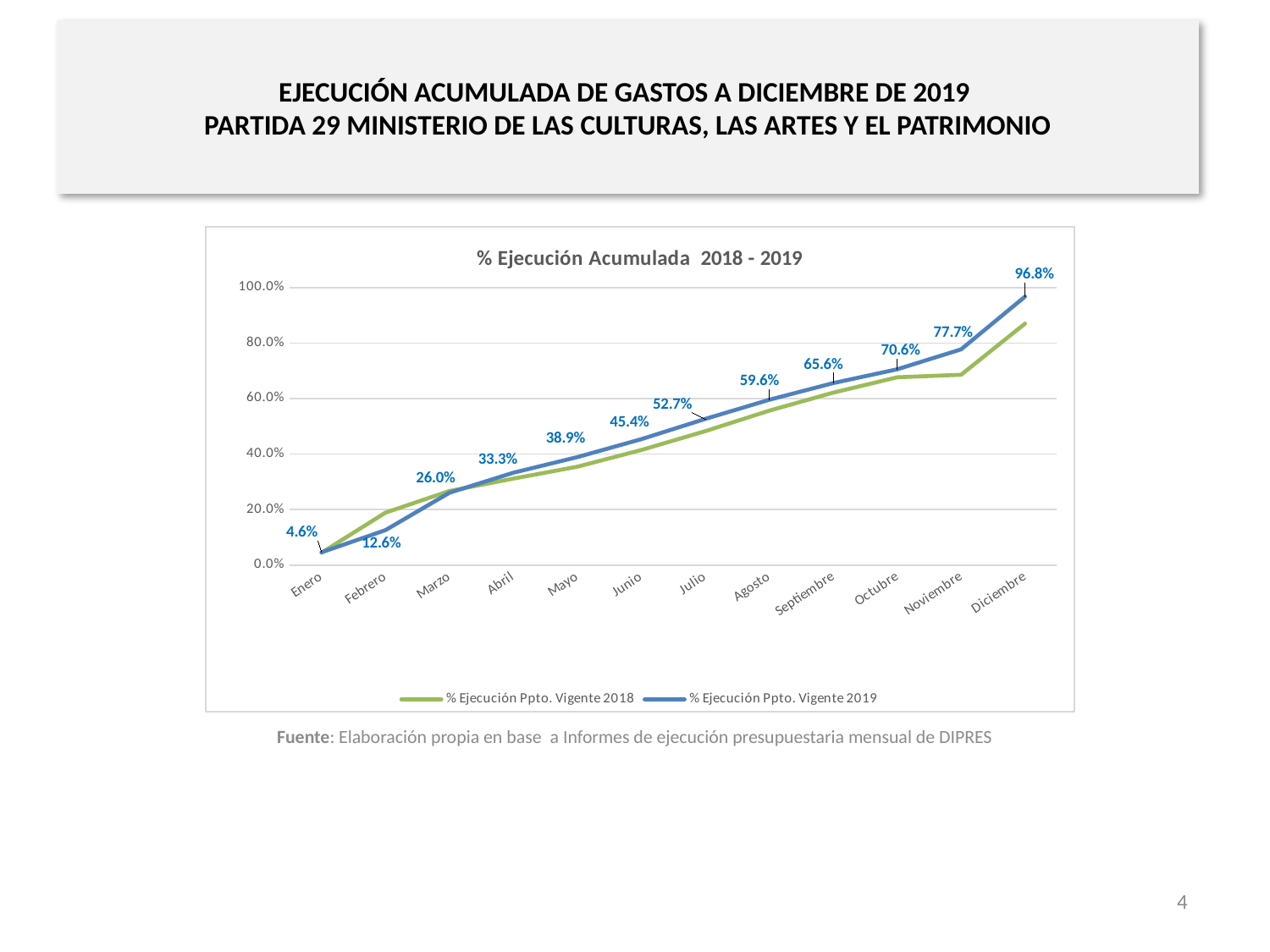
What is the value of % Ejecución Ppto. Vigente 2019 in Enero? 4.6% What is the difference between the 2019 values for Diciembre and Noviembre? 19.1% What type of chart is shown on the slide? line chart Is the value for % Ejecución Ppto. Vigente 2018 in Diciembre greater or less than 80.0%? greater What is the value of % Ejecución Ppto. Vigente 2019 in Octubre? 70.6% In which month is the % Ejecución Ppto. Vigente 2019 series lowest? Enero How many months are shown on the x axis? 12 How many series does the legend list? 2 In which month is the % Ejecución Ppto. Vigente 2019 series highest? Diciembre In Febrero, which series has the larger value, 2018 or 2019? % Ejecución Ppto. Vigente 2018 What is the value of % Ejecución Ppto. Vigente 2019 in Diciembre? 96.8% What is the value of % Ejecución Ppto. Vigente 2019 in Julio? 52.7%